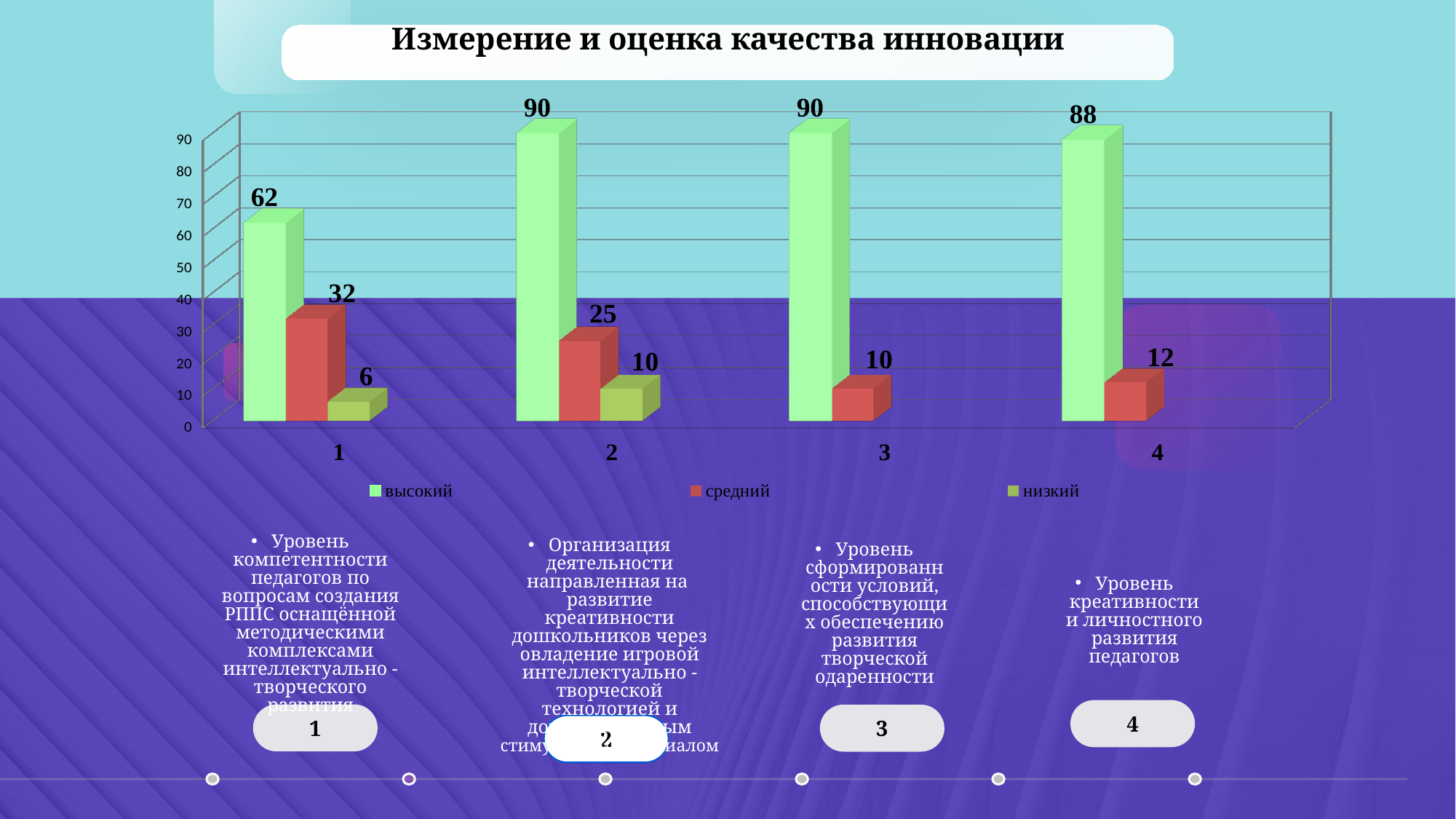
What is the difference between the высокий and средний values for category 1? 30 What kind of chart is shown on the slide? bar chart What is the difference between the высокий values for category 2 and category 4? 2 What is the value of the низкий series for category 1? 6 What is the value of the средний series for category 2? 25 What is the value of the высокий series for category 1? 62 Which is larger: the средний value for category 3 or the средний value for category 4? category 4 How many series does the legend list? 3 What is the value of the средний series for category 4? 12 Which category has the lowest value for the высокий series? 1 How many categories are shown on the x axis? 4 Which category has the highest value for the средний series? 1